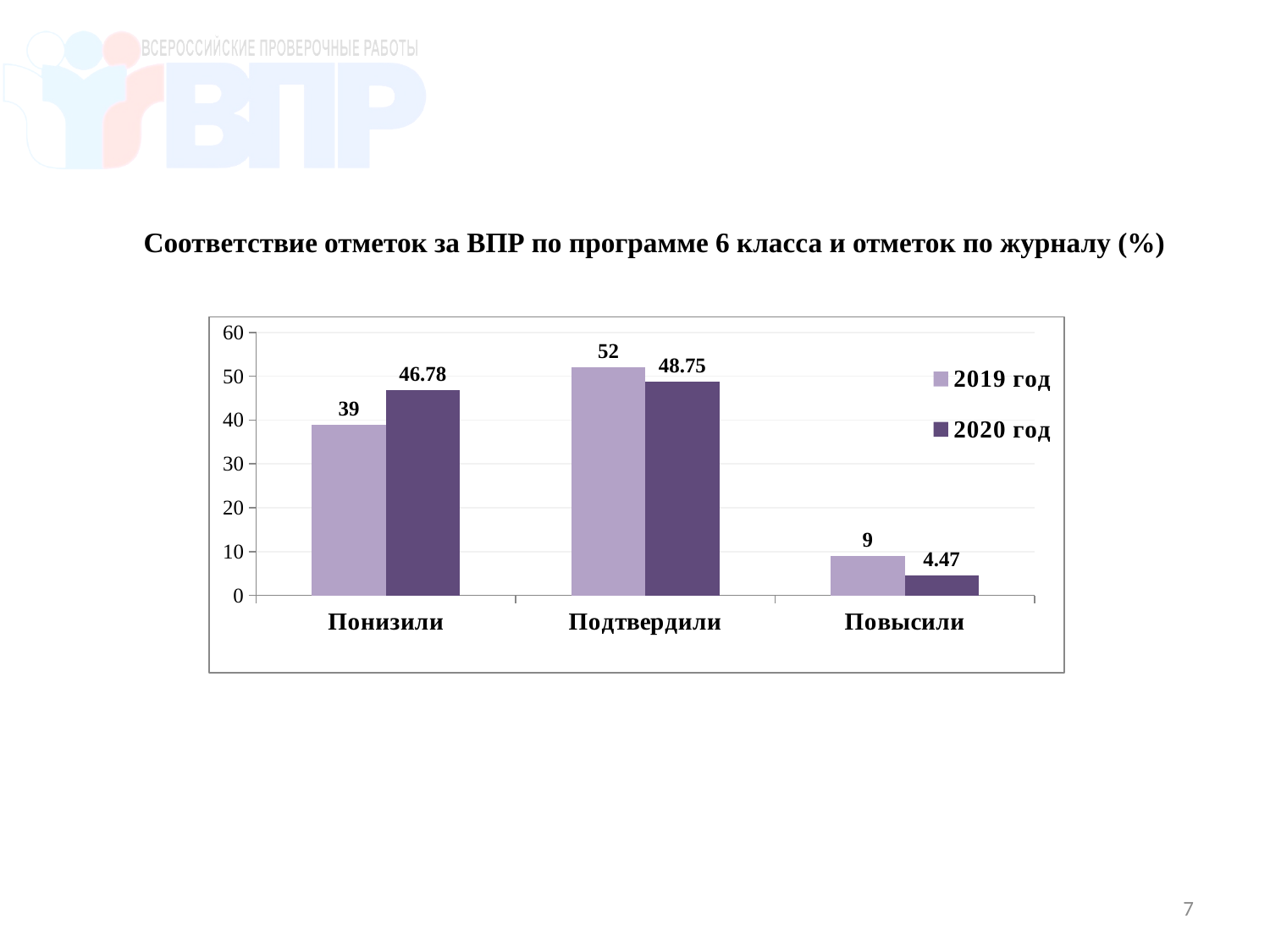
Which category has the lowest value in the 2020 год series? Повысили What kind of chart is shown on the slide? Bar chart Which is larger for Подтвердили: the 2019 год value or the 2020 год value? 2019 год What is the value for Понизили in the 2019 год series? 39 How many series does the legend list? 2 Which category has the highest value in the 2019 год series? Подтвердили What is the title of the chart? Соответствие отметок за ВПР по программе 6 класса и отметок по журналу (%) What is the difference between the 2020 год and 2019 год values for Понизили? 7.78 What is the value for Подтвердили in the 2020 год series? 48.75 How many categories are shown on the x axis? 3 What is the value for Повысили in the 2020 год series? 4.47 What is the difference between the 2019 год and 2020 год values for Повысили? 4.53